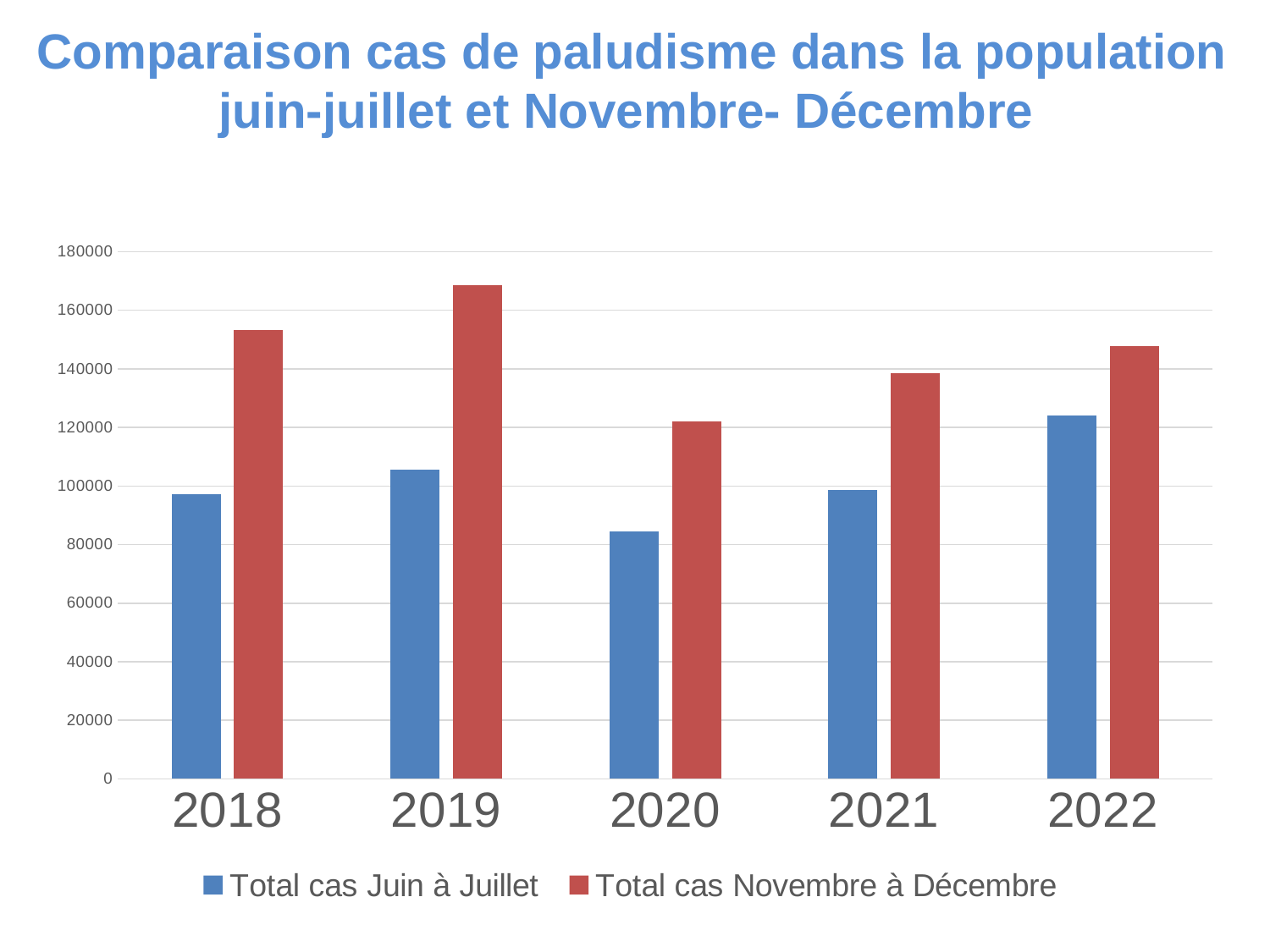
Which year has the highest value for Total cas Novembre à Décembre? 2019 Which year has the highest value for Total cas Juin à Juillet? 2022 What kind of chart is shown on the slide? bar chart Is the value for Total cas Juin à Juillet in 2022 greater or less than 120000? greater How many years are shown on the x axis? 5 Which year has the lowest value for Total cas Novembre à Décembre? 2020 Which year has the lowest value for Total cas Juin à Juillet? 2020 How many series does the legend list? 2 Which is larger: Total cas Novembre à Décembre in 2019 or in 2022? 2019 Which series is shown in red in the legend? Total cas Novembre à Décembre Is the value for Total cas Juin à Juillet in 2020 greater or less than 100000? less Is the value for Total cas Novembre à Décembre in 2019 greater or less than 160000? greater